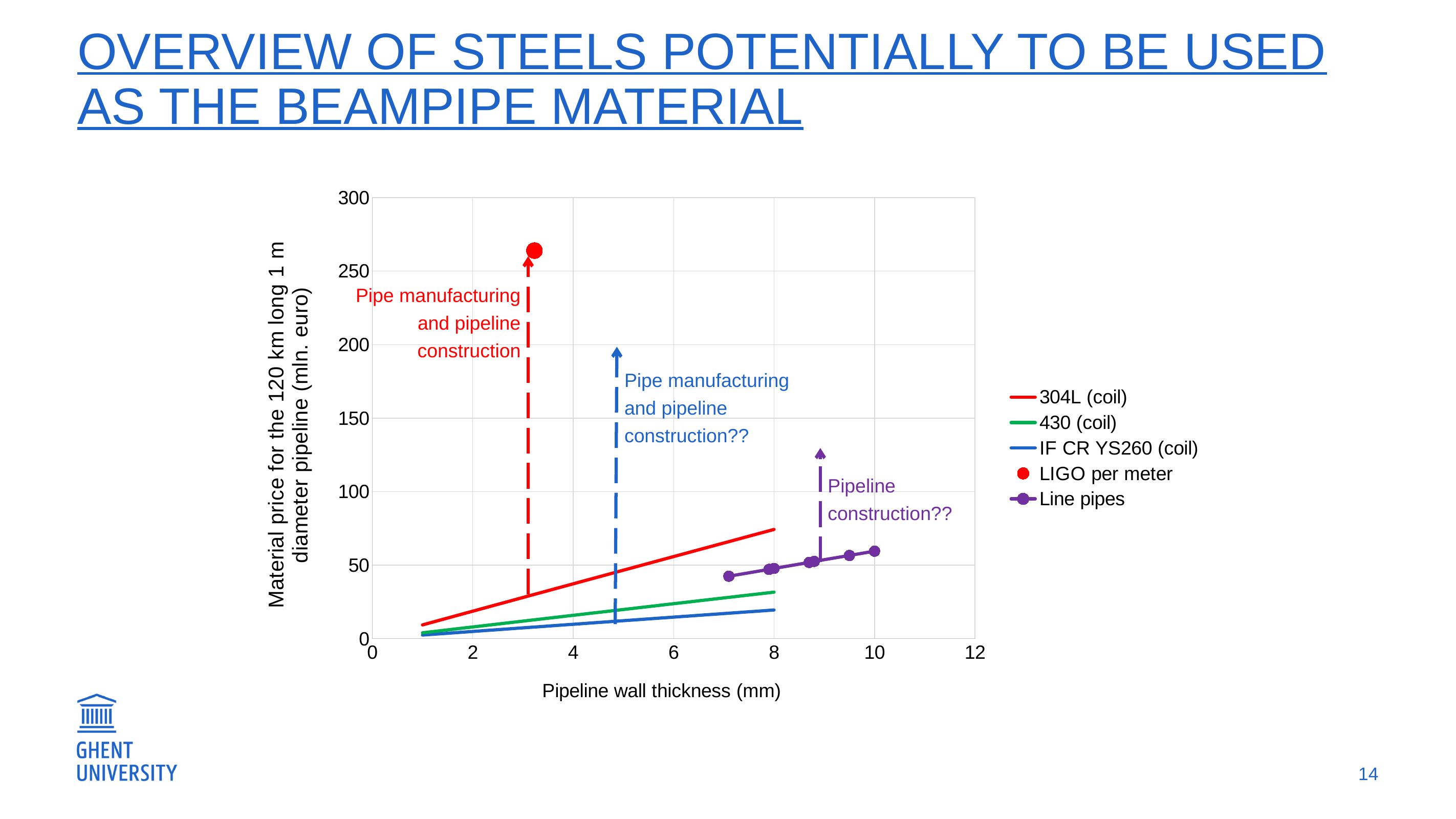
Does the material price for 304L (coil) rise or fall as pipeline wall thickness increases? rise Which is larger: the value for LIGO per meter or the highest value for Line pipes? LIGO per meter Is the value for Line pipes at a wall thickness of 10 mm greater or less than 50? greater Among the three coil series, which has the lowest material price at a wall thickness of 8 mm? IF CR YS260 (coil) Is the value for LIGO per meter greater or less than 250? greater What is the label of the x axis? Pipeline wall thickness (mm) Is the value for 304L (coil) at a wall thickness of 8 mm greater or less than 100? less Among the three coil series, which has the highest material price at a wall thickness of 8 mm? 304L (coil) How many series does the chart legend list? 5 Which series is drawn in green in the legend? 430 (coil) What kind of chart is shown on the slide? line chart